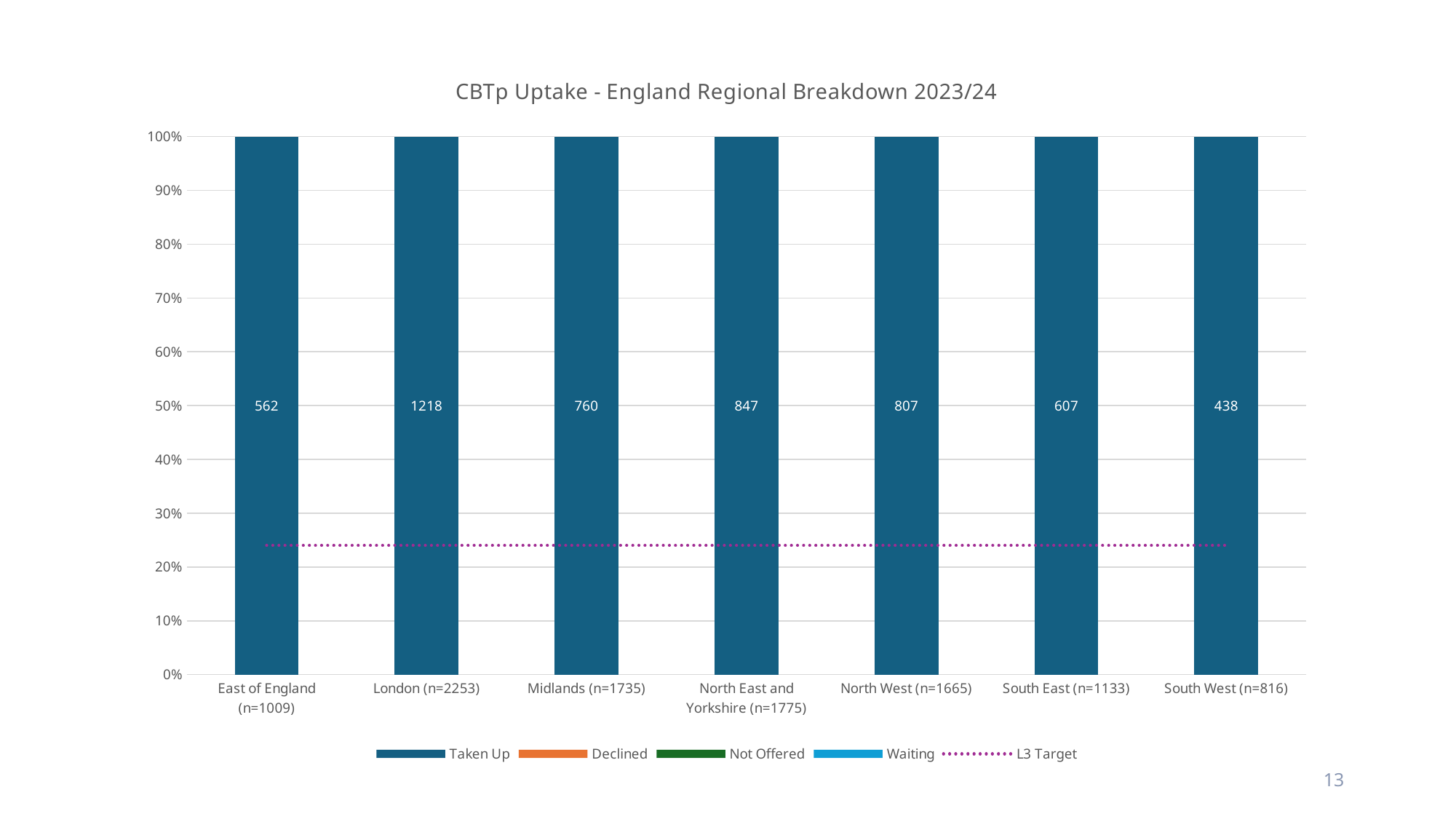
How many regions are shown on the x axis? 7 Which has the larger Taken Up data label, Midlands (n=1735) or North West (n=1665)? North West (n=1665) Which region has the highest Taken Up data label? London (n=2253) What is the difference between the Taken Up data labels for London (n=2253) and East of England (n=1009)? 656 What data label is shown on the Taken Up bar for London (n=2253)? 1218 What is the title of the chart? CBTp Uptake - England Regional Breakdown 2023/24 What data label is shown on the Taken Up bar for North East and Yorkshire (n=1775)? 847 Which region has the lowest Taken Up data label? South West (n=816) How many entries does the legend list? 5 What kind of chart is shown on the slide? bar chart Is the L3 Target dotted line greater or less than 30%? less What data label is shown on the Taken Up bar for South West (n=816)? 438